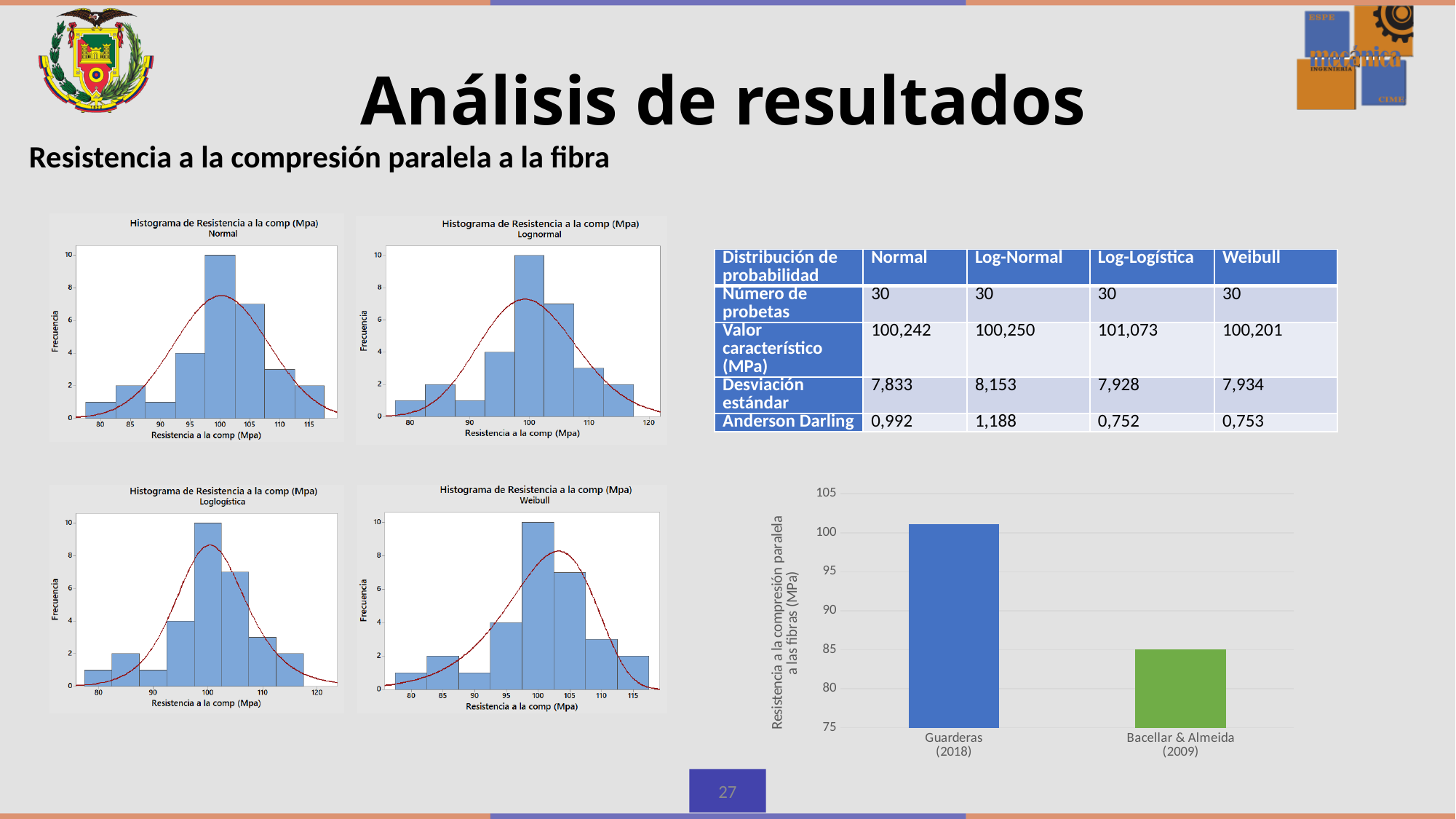
In the bottom-right bar chart, is the value for Guarderas (2018) greater or less than 100? greater In the histogram titled 'Histograma de Resistencia a la comp (Mpa) Lognormal', what is the x-axis label? Resistencia a la comp (Mpa) What kind of chart is shown at the bottom right of the slide, comparing Guarderas (2018) and Bacellar & Almeida (2009)? bar chart In the histogram titled 'Histograma de Resistencia a la comp (Mpa) Normal', what is the frequency of the tallest bar? 10 In the bottom-right bar chart, is the value for Bacellar & Almeida (2009) greater or less than 90? less In the bottom-right bar chart, how many categories are plotted? 2 In the histogram titled 'Histograma de Resistencia a la comp (Mpa) Weibull', how many bars are there? 8 In the histogram titled 'Histograma de Resistencia a la comp (Mpa) Loglogística', what is the y-axis label? Frecuencia In the histogram titled 'Histograma de Resistencia a la comp (Mpa) Normal', how many bars are there? 8 In the bottom-right bar chart, which has the higher compressive strength, Guarderas (2018) or Bacellar & Almeida (2009)? Guarderas (2018) In the bottom-right bar chart, what is the value for Bacellar & Almeida (2009)? 85 In the histogram titled 'Histograma de Resistencia a la comp (Mpa) Weibull', what is the frequency of the tallest bar? 10